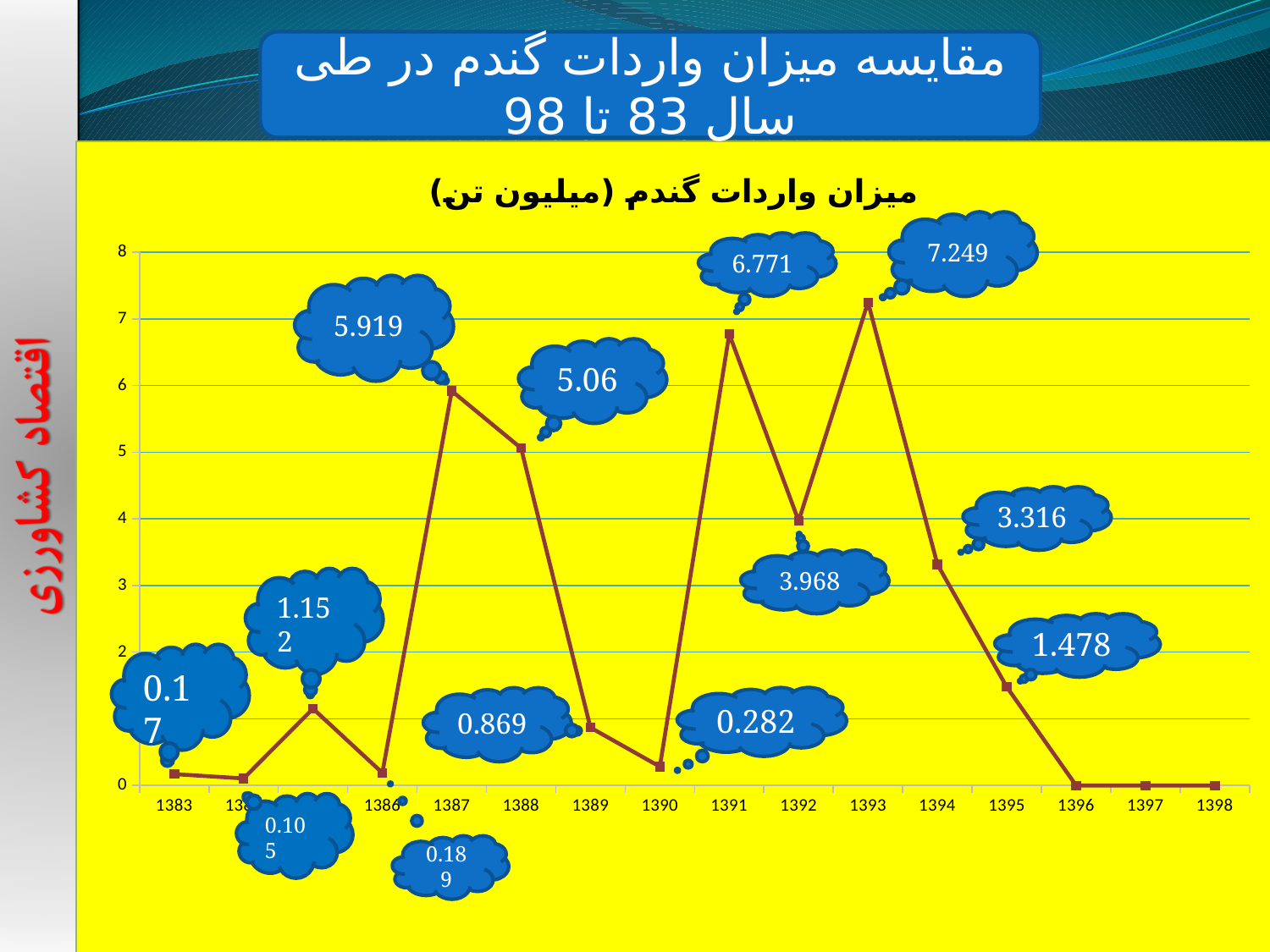
Which year has the highest wheat import value? 1393 What is the wheat import value for the year 1395? 1.478 Do the wheat import values rise or fall from 1393 to 1396? fall What is the difference between the wheat import values for 1387 and 1388? 0.859 What is the difference between the wheat import values for 1393 and 1391? 0.478 What is the wheat import value for the year 1391? 6.771 What kind of chart is shown on the slide? line chart How many years are plotted on the x axis? 16 What is the wheat import value for the year 1393? 7.249 What is the wheat import value for the year 1387? 5.919 Which year has the larger wheat import value, 1392 or 1394? 1392 Is the wheat import value for 1396 greater or less than 1? less